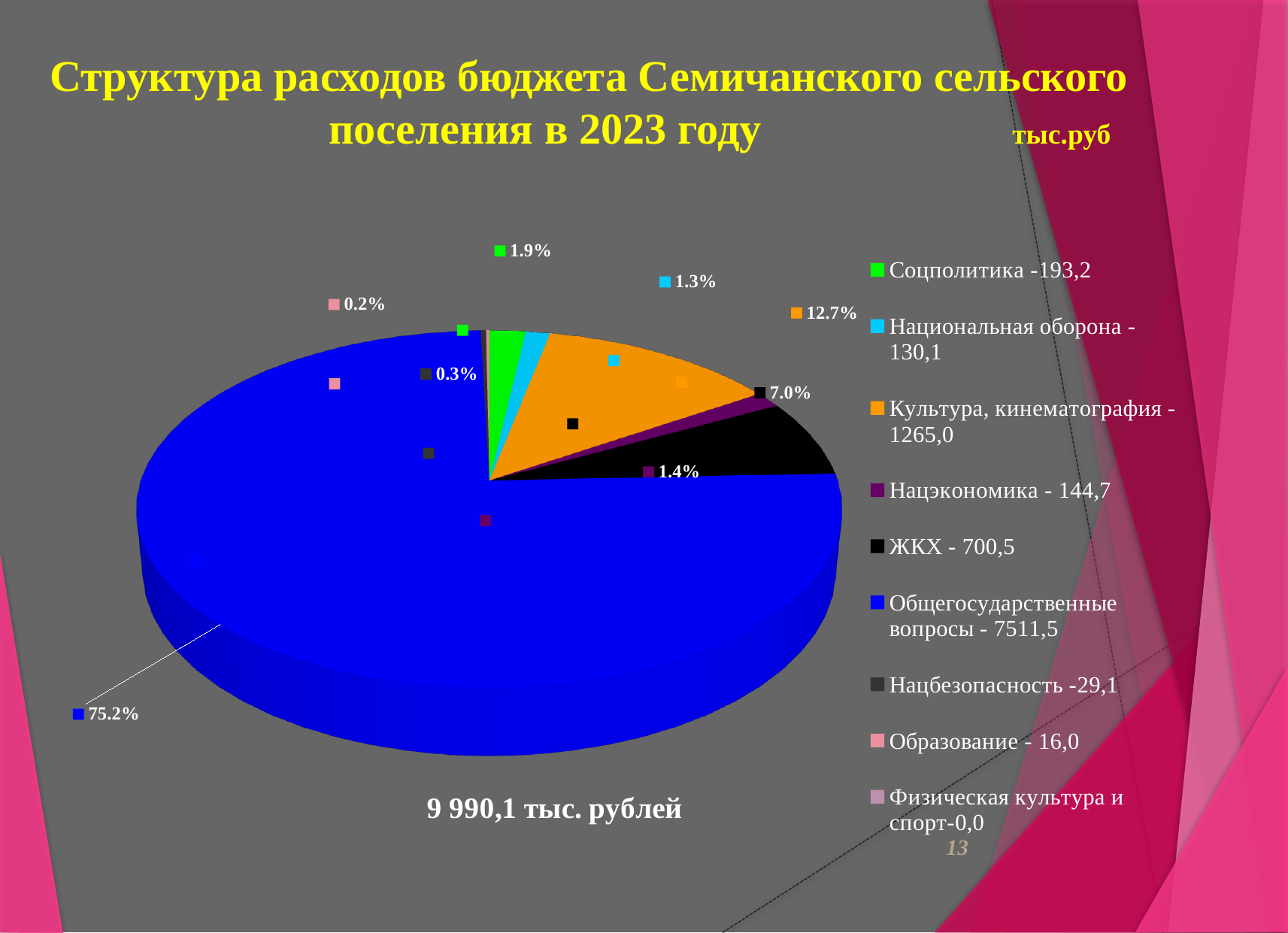
Which category has the smallest value in the legend? Физическая культура и спорт What share of the pie does the blue slice (Общегосударственные вопросы) take? 75.2% What is the value for Культура, кинематография in the legend? 1265,0 Which category has the largest share of the pie? Общегосударственные вопросы How many categories does the legend of the pie chart list? 9 Which is larger, the value for Нацэкономика or the value for Национальная оборона? Нацэкономика What share of the pie does the orange slice (Культура, кинематография) take? 12.7% What is the difference between the values for ЖКХ and Соцполитика? 507,3 What is the value for ЖКХ in the legend? 700,5 What total amount is printed below the pie chart? 9 990,1 тыс. рублей What is the value for Общегосударственные вопросы in the legend? 7511,5 What kind of chart is shown on the slide? pie chart